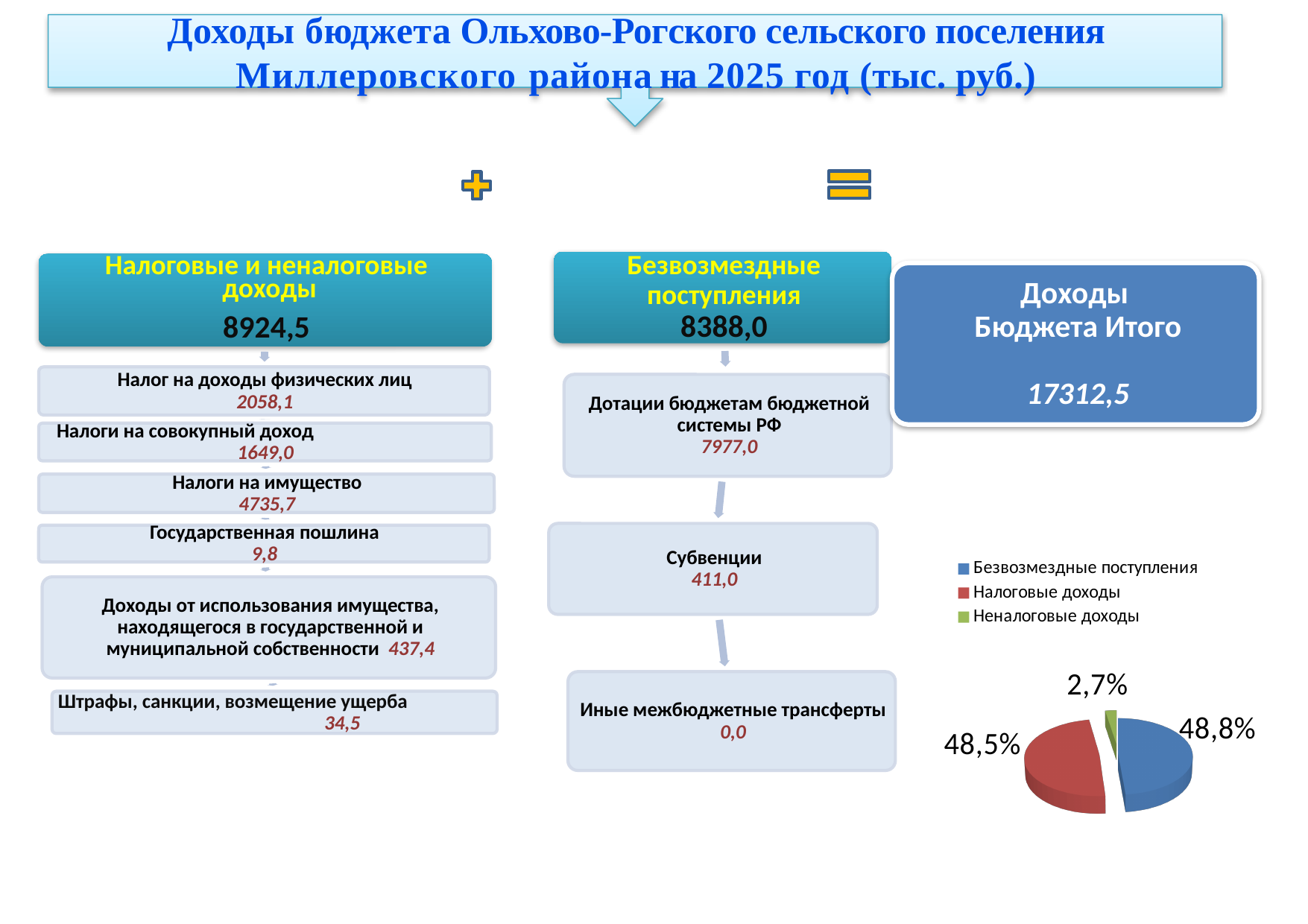
Which legend entry in the pie chart is shown in green? Неналоговые доходы What kind of chart is shown on the slide? pie chart Which colour represents Налоговые доходы in the pie chart? red What share of the pie chart is labelled for Неналоговые доходы? 2,7% How many slices does the pie chart have? 3 How many entries does the pie chart's legend list? 3 Which is larger in the pie chart: Безвозмездные поступления or Неналоговые доходы? Безвозмездные поступления Which slice of the pie chart is the smallest? Неналоговые доходы